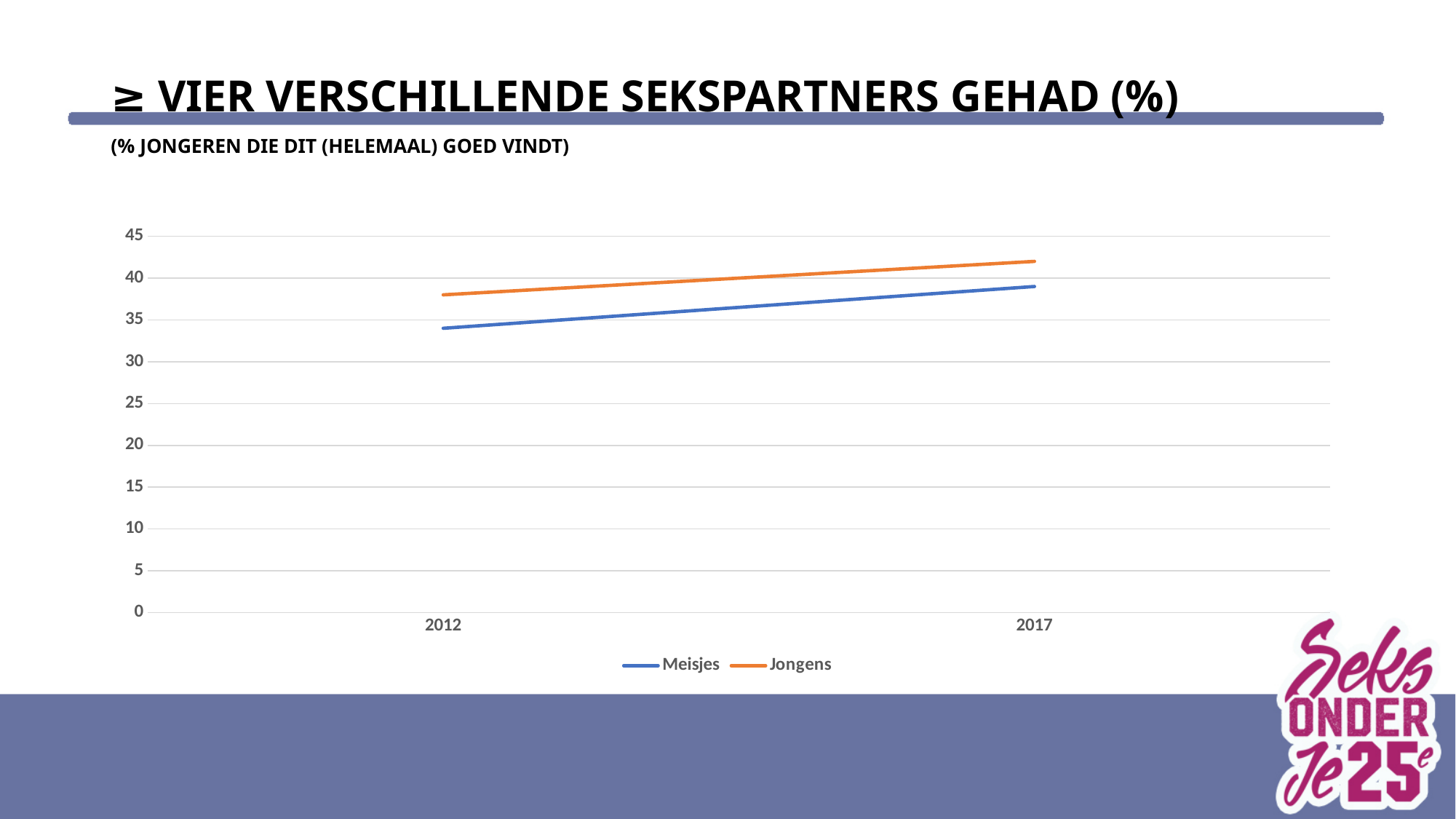
Does the value for Meisjes rise or fall from 2012 to 2017? rise In 2012, which series has the higher value, Meisjes or Jongens? Jongens What kind of chart is shown on the slide? line chart Which years are shown on the x axis? 2012 and 2017 How many series does the legend list? 2 In 2017, which series has the higher value, Meisjes or Jongens? Jongens Is the value for Jongens in 2017 greater or less than 40? greater How many years are shown on the x axis? 2 Which series are listed in the legend? Meisjes and Jongens Does the value for Jongens rise or fall from 2012 to 2017? rise Is the value for Jongens in 2012 greater or less than 40? less Is the value for Meisjes in 2012 greater or less than 30? greater